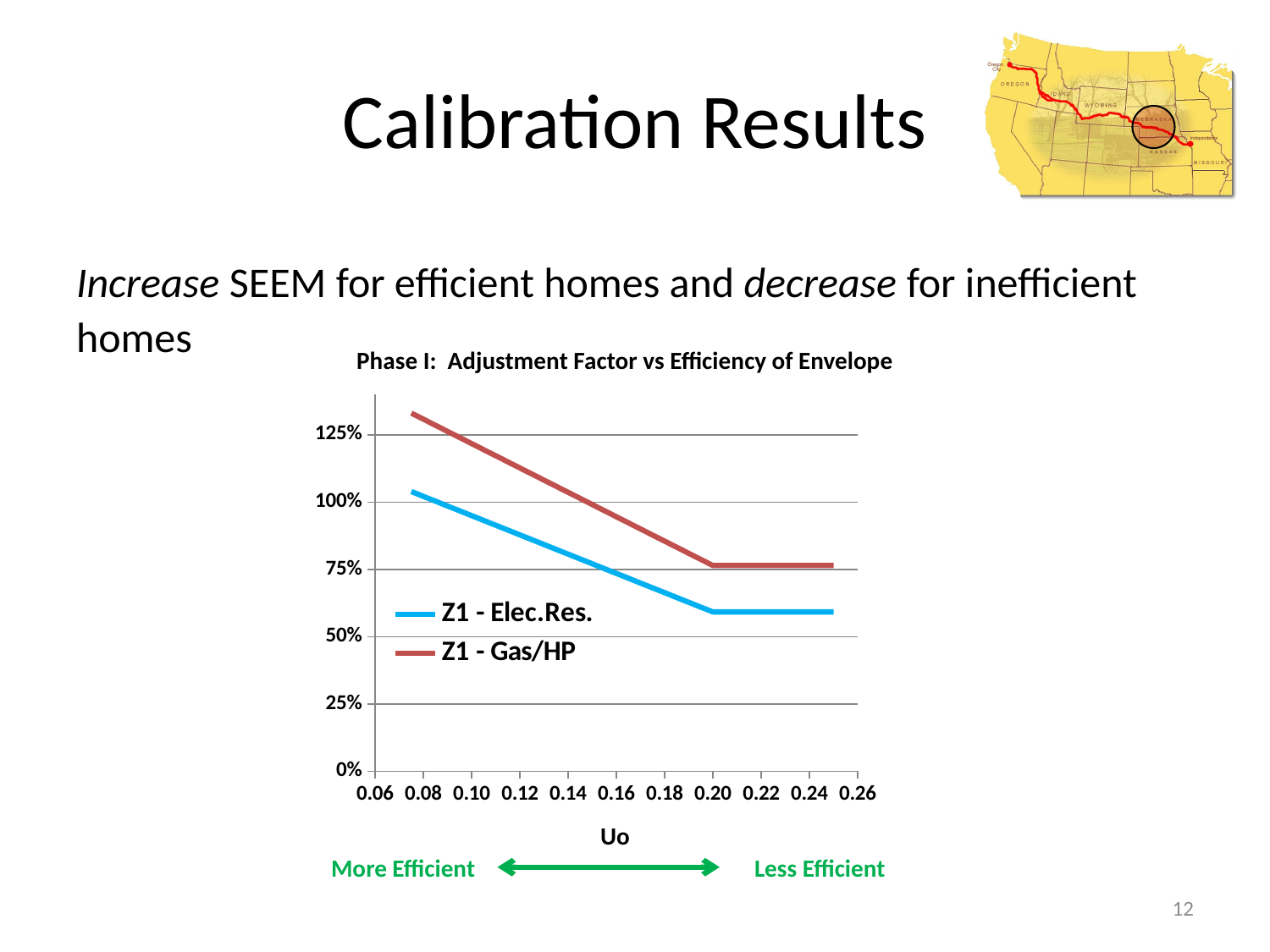
Do the values of the Z1 - Elec.Res. series rise or fall as Uo increases from 0.08 to 0.20? Fall What kind of chart is shown on the slide? Line chart Is the value for Z1 - Elec.Res. at Uo = 0.20 greater or less than 75%? less Is the value for Z1 - Elec.Res. at Uo = 0.24 greater or less than 50%? greater How many series does the chart legend list? 2 Is the value for Z1 - Gas/HP at Uo = 0.24 greater or less than 100%? less What label is shown on the x axis of the chart? Uo At Uo = 0.14, which series has the higher value, Z1 - Elec.Res. or Z1 - Gas/HP? Z1 - Gas/HP What is the title of the chart? Phase I: Adjustment Factor vs Efficiency of Envelope Do the values of the Z1 - Gas/HP series rise or fall as Uo increases from 0.08 to 0.20? Fall